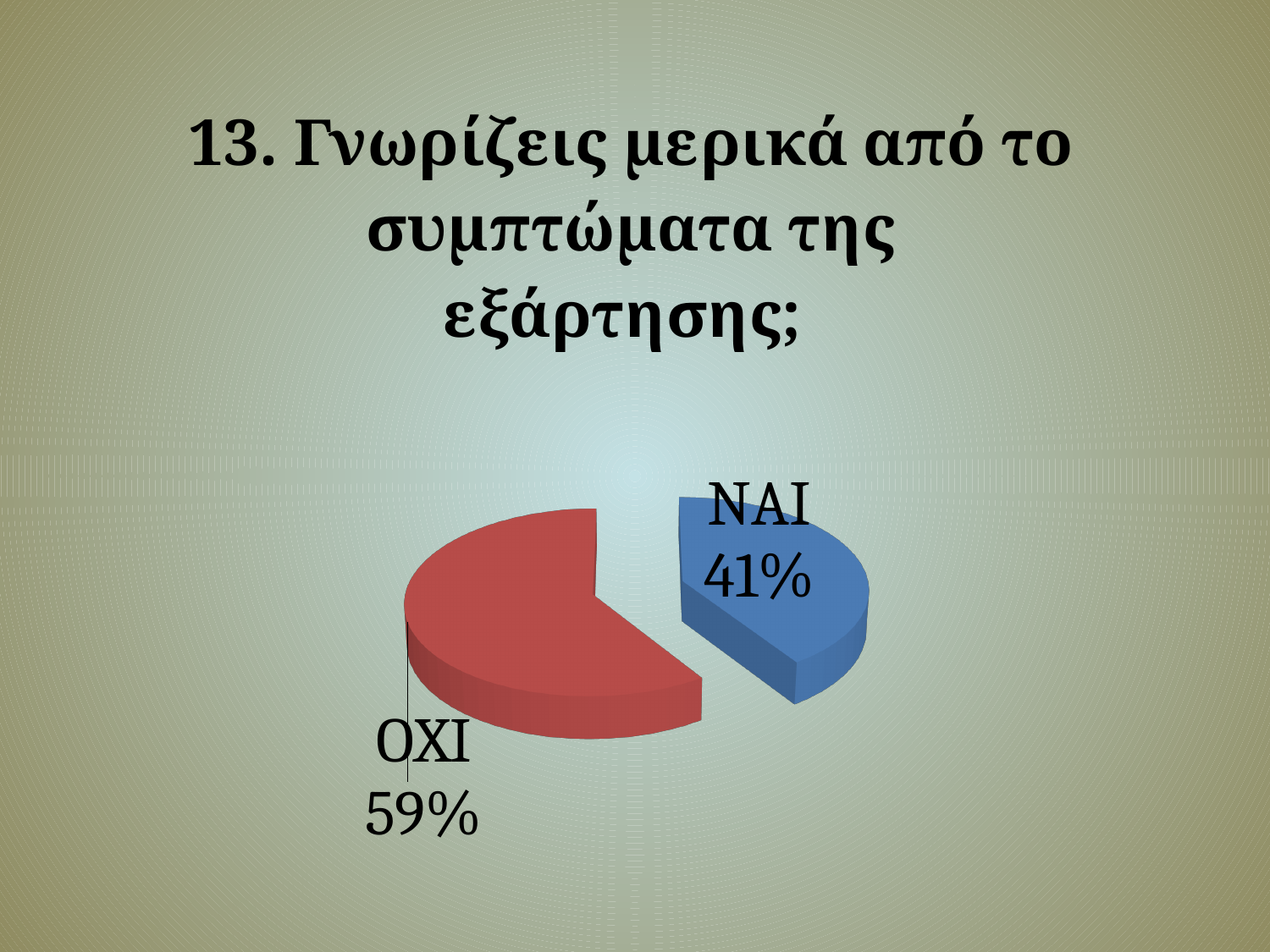
What share of the pie does the ΟΧΙ slice represent? 59% What percentage of respondents answered ΝΑΙ? 41% What percentage of respondents answered ΟΧΙ? 59% Which response has the largest share of the pie? ΟΧΙ Which response has the smallest share of the pie? ΝΑΙ How many slices does the pie chart have? 2 What colour is the ΟΧΙ slice? Red What colour is the ΝΑΙ slice? Blue What is the difference in percentage points between ΟΧΙ and ΝΑΙ? 18 Which is larger, the share for ΝΑΙ or the share for ΟΧΙ? ΟΧΙ What kind of chart is shown on the slide? Pie chart